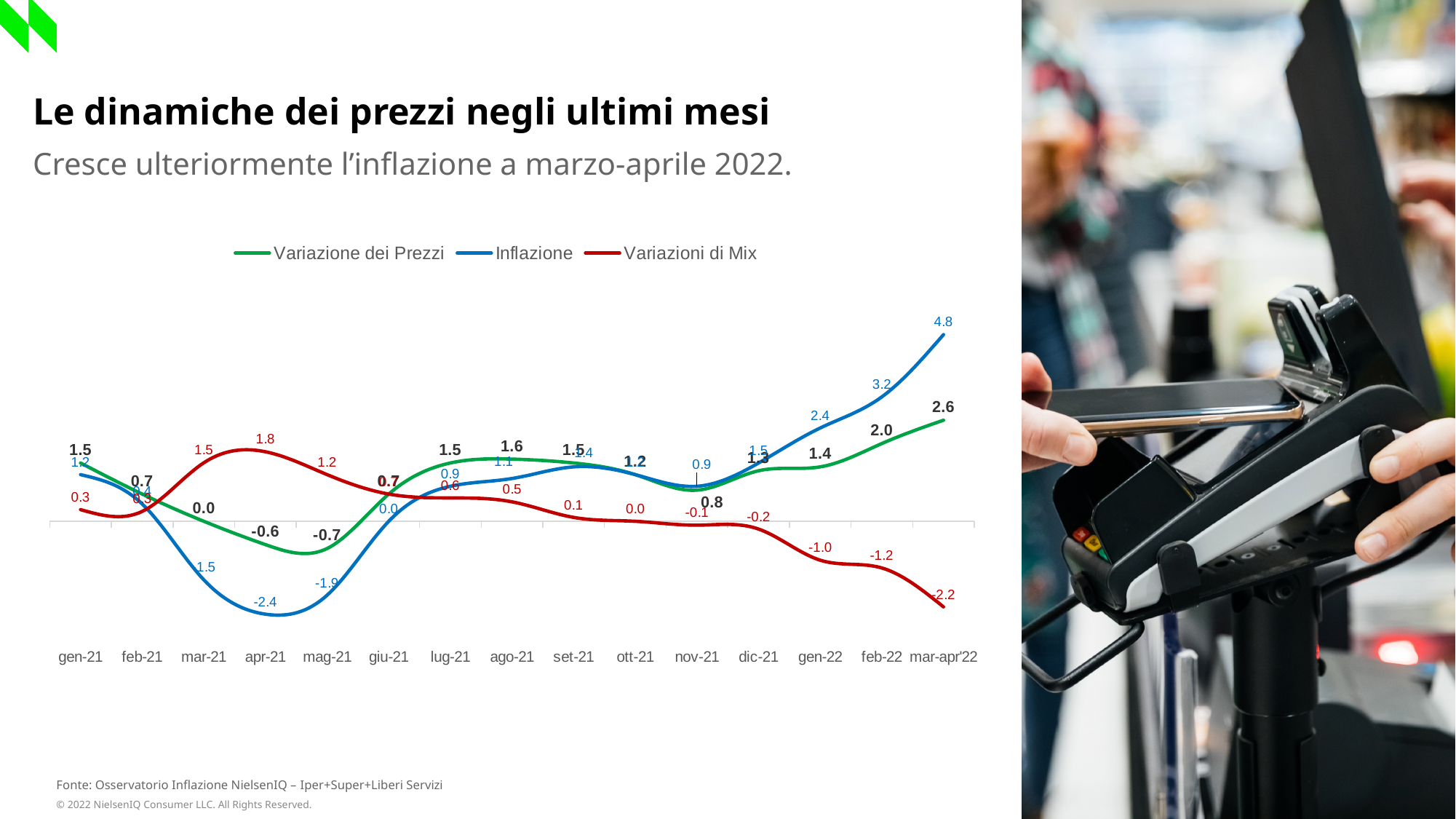
What is the value of Variazione dei Prezzi at mar-apr'22? 2.6 At mar-apr'22, which is larger: Inflazione or Variazione dei Prezzi? Inflazione What is the value of Inflazione at mar-apr'22? 4.8 Does Variazioni di Mix rise or fall from gen-22 to mar-apr'22? Fall How many series does the legend list? 3 What kind of chart is shown on the slide? Line chart In which month does Inflazione reach its highest value? mar-apr'22 In which month does Inflazione reach its lowest value? apr-21 What is the difference between the Inflazione values at mar-apr'22 and feb-22? 1.6 In which month does Variazione dei Prezzi reach its lowest value? mag-21 How many time periods are shown on the x axis? 15 What is the value of Variazioni di Mix at apr-21? 1.8